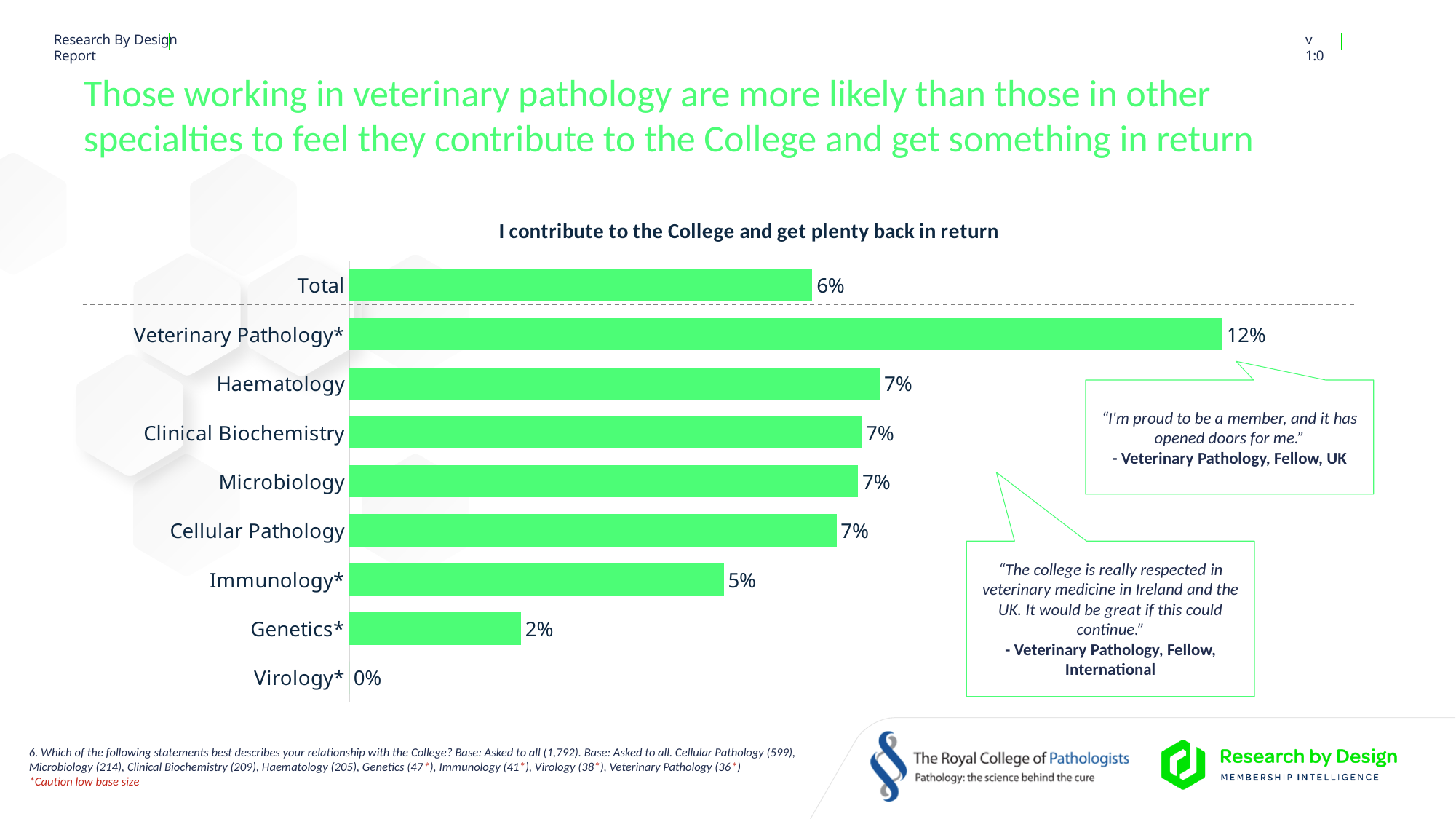
What is the value for Immunology*? 5% What is the value for Total? 6% What kind of chart is shown on the slide? Bar chart What is the value for Veterinary Pathology*? 12% What is the difference between the values for Immunology* and Genetics*? 3% Which category has the lowest value? Virology* What is the difference between the values for Veterinary Pathology* and Total? 6% How many categories are shown in the chart, including Total? 9 Which category has the highest value? Veterinary Pathology* Which is larger, the value for Haematology or the value for Immunology*? Haematology What is the title of the chart? I contribute to the College and get plenty back in return What is the value for Genetics*? 2%